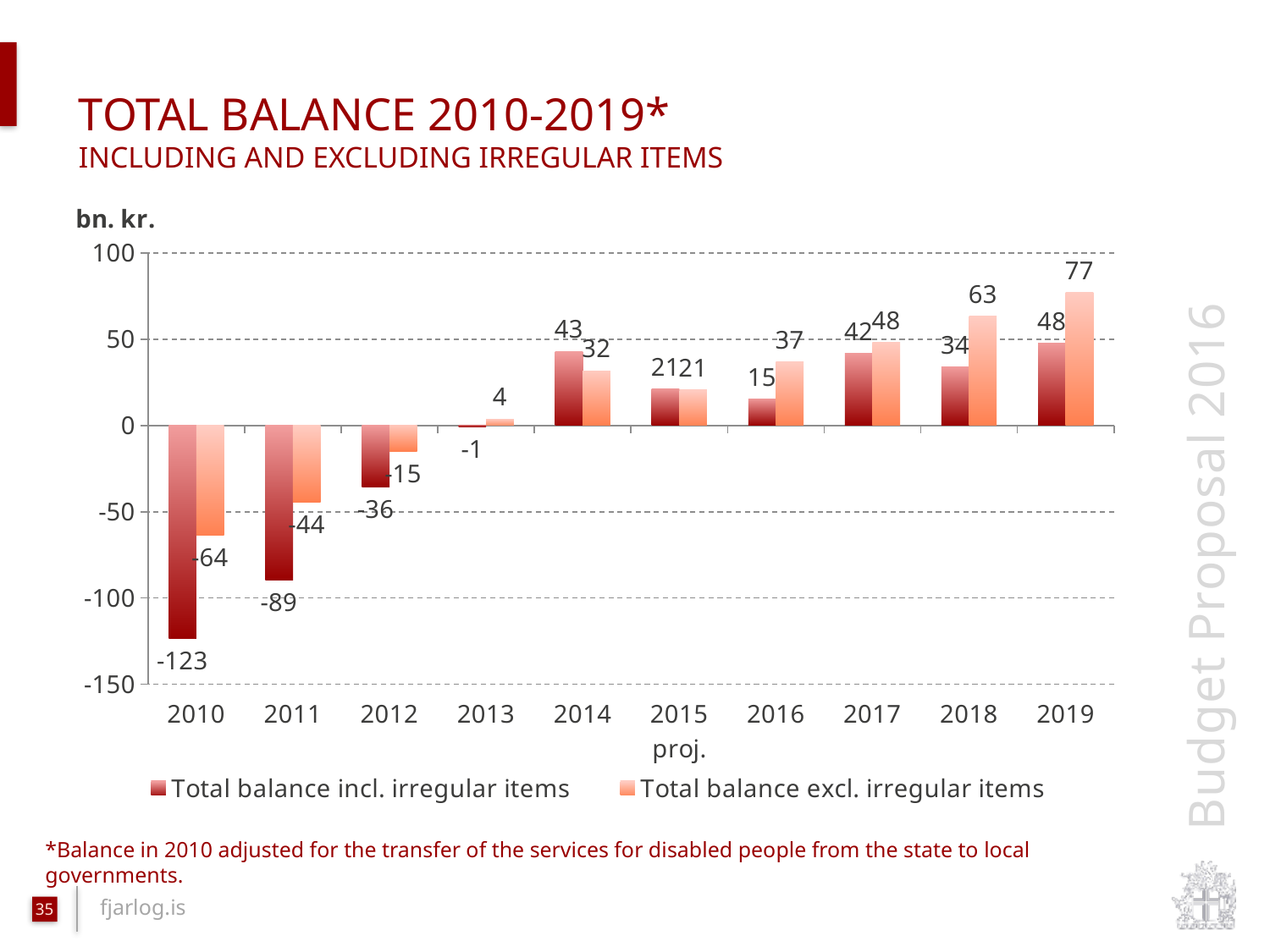
Which year has the highest value for Total balance excl. irregular items? 2019 How many series does the legend list? 2 What is the value of Total balance excl. irregular items for 2013? 4 What is the value of Total balance incl. irregular items for 2010? -123 Does Total balance excl. irregular items rise or fall from 2016 to 2019? Rise Which year has the lowest value for Total balance incl. irregular items? 2010 What kind of chart is shown on the slide? Bar chart What is the difference between Total balance excl. irregular items and Total balance incl. irregular items in 2018? 29 What unit is shown above the y axis of the chart? bn. kr. How many years are shown on the x axis? 10 What is the value of Total balance excl. irregular items for 2019? 77 In 2014, which series has the larger value: Total balance incl. irregular items or Total balance excl. irregular items? Total balance incl. irregular items